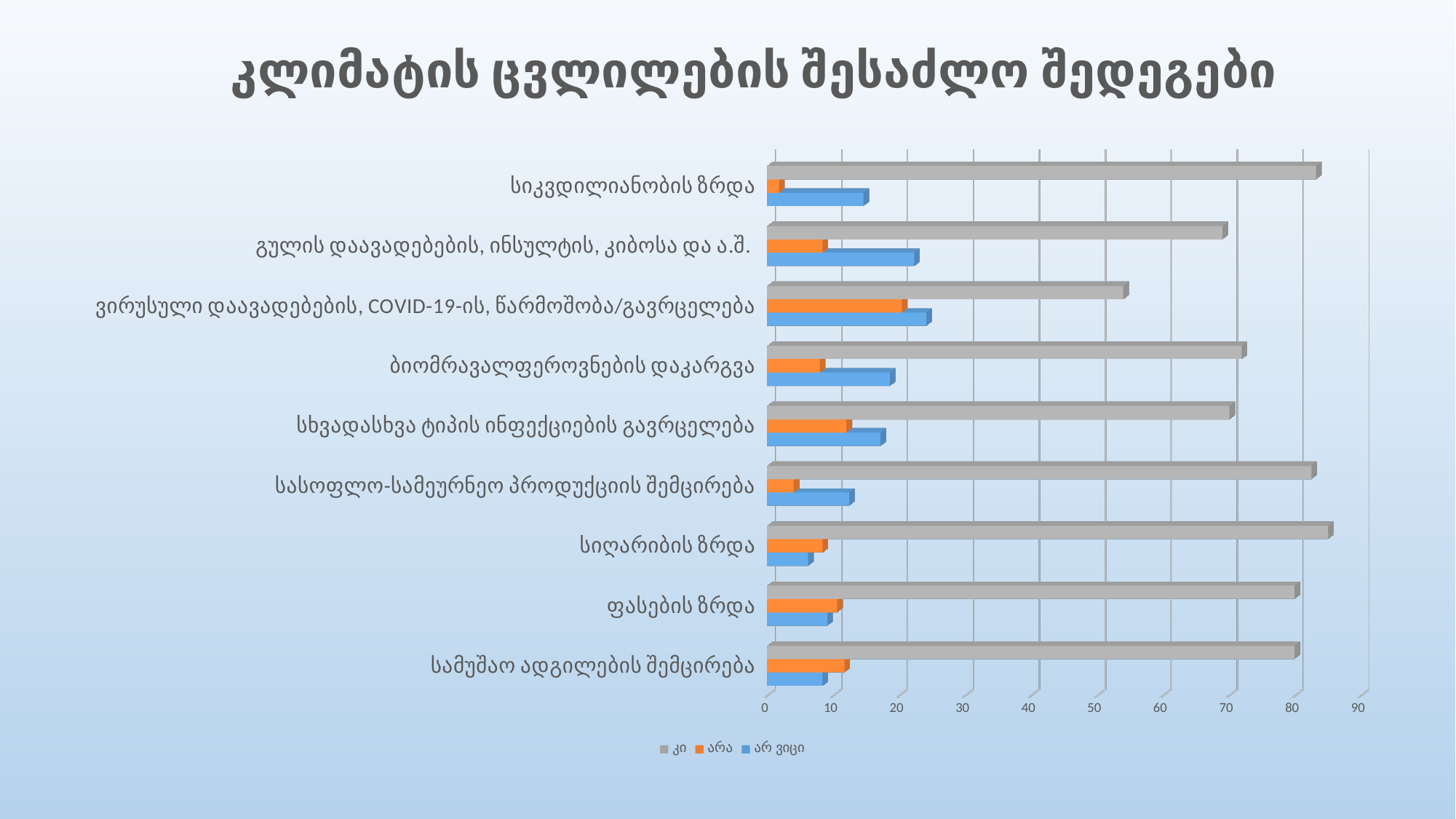
Which is larger for the არ ვიცი series: ვირუსული დაავადებების, COVID-19-ის, წარმოშობა/გავრცელება or სიღარიბის ზრდა? ვირუსული დაავადებების, COVID-19-ის, წარმოშობა/გავრცელება Is the კი value for სიკვდილიანობის ზრდა greater or less than 70? greater Which category has the highest value for the არა series? ვირუსული დაავადებების, COVID-19-ის, წარმოშობა/გავრცელება Which series is shown in orange? არა Which is larger for the კი series: გულის დაავადებების, ინსულტის, კიბოსა და ა.შ. or ვირუსული დაავადებების, COVID-19-ის, წარმოშობა/გავრცელება? გულის დაავადებების, ინსულტის, კიბოსა და ა.შ. What kind of chart is shown on the slide? bar chart How many series does the legend list? 3 Is the კი value for ვირუსული დაავადებების, COVID-19-ის, წარმოშობა/გავრცელება greater or less than 60? less Which category has the lowest value for the კი series? ვირუსული დაავადებების, COVID-19-ის, წარმოშობა/გავრცელება What is the title of the chart? კლიმატის ცვლილების შესაძლო შედეგები How many categories are plotted on the chart? 9 Is the არა value for სიკვდილიანობის ზრდა greater or less than 10? less